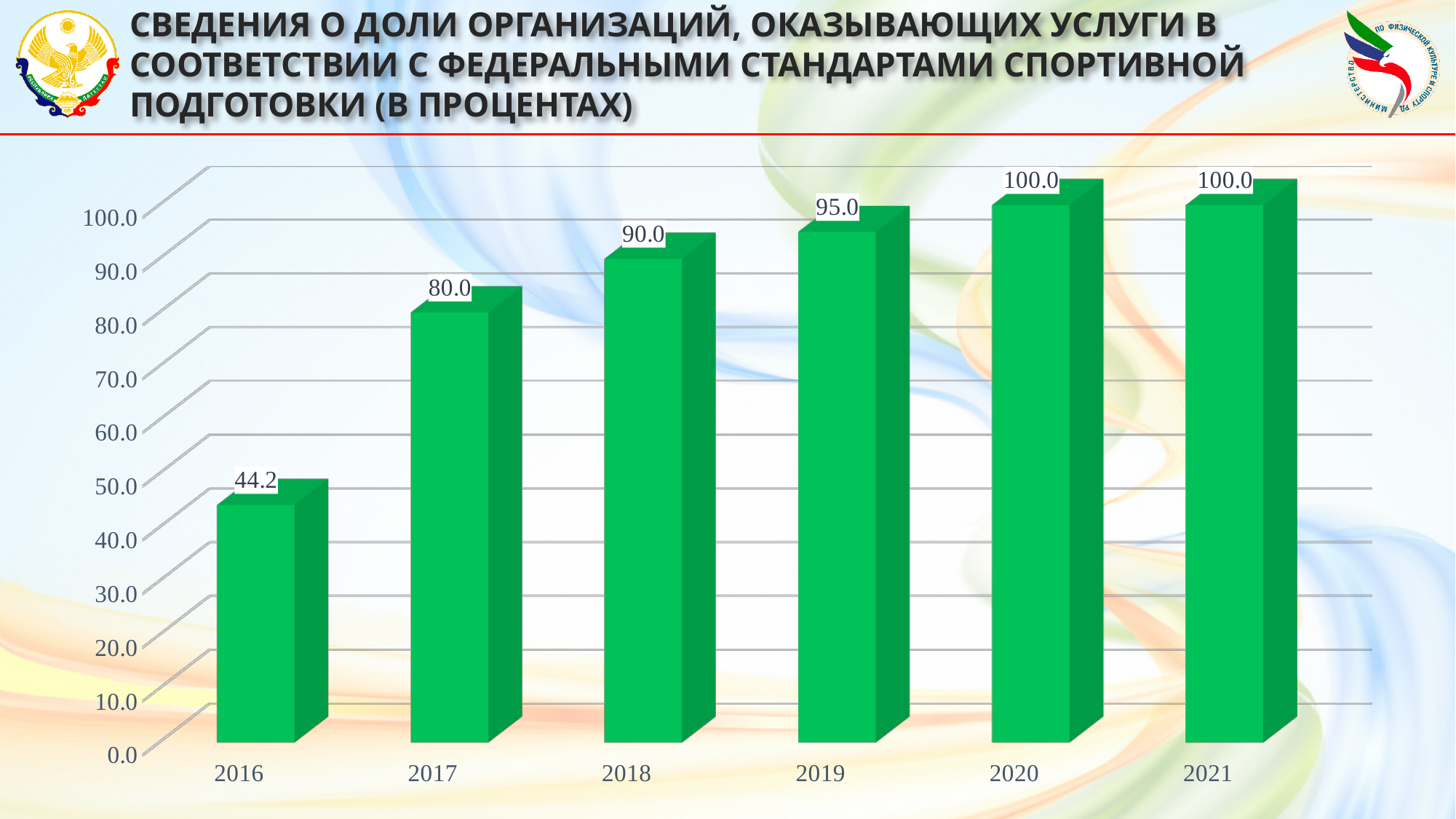
What is the value for 2019? 95.0 What is the difference between the values for 2017 and 2016? 35.8 Which is larger, the value for 2018 or the value for 2019? 2019 What is the value for 2016? 44.2 Do the values rise or fall from 2016 to 2021? rise What kind of chart is shown on the slide? bar chart Is the value for 2017 greater or less than 70.0? greater Which year has the lowest value? 2016 What is the difference between the values for 2020 and 2018? 10.0 What colour are the bars in the chart? green What is the value for 2018? 90.0 How many years are shown on the x axis? 6